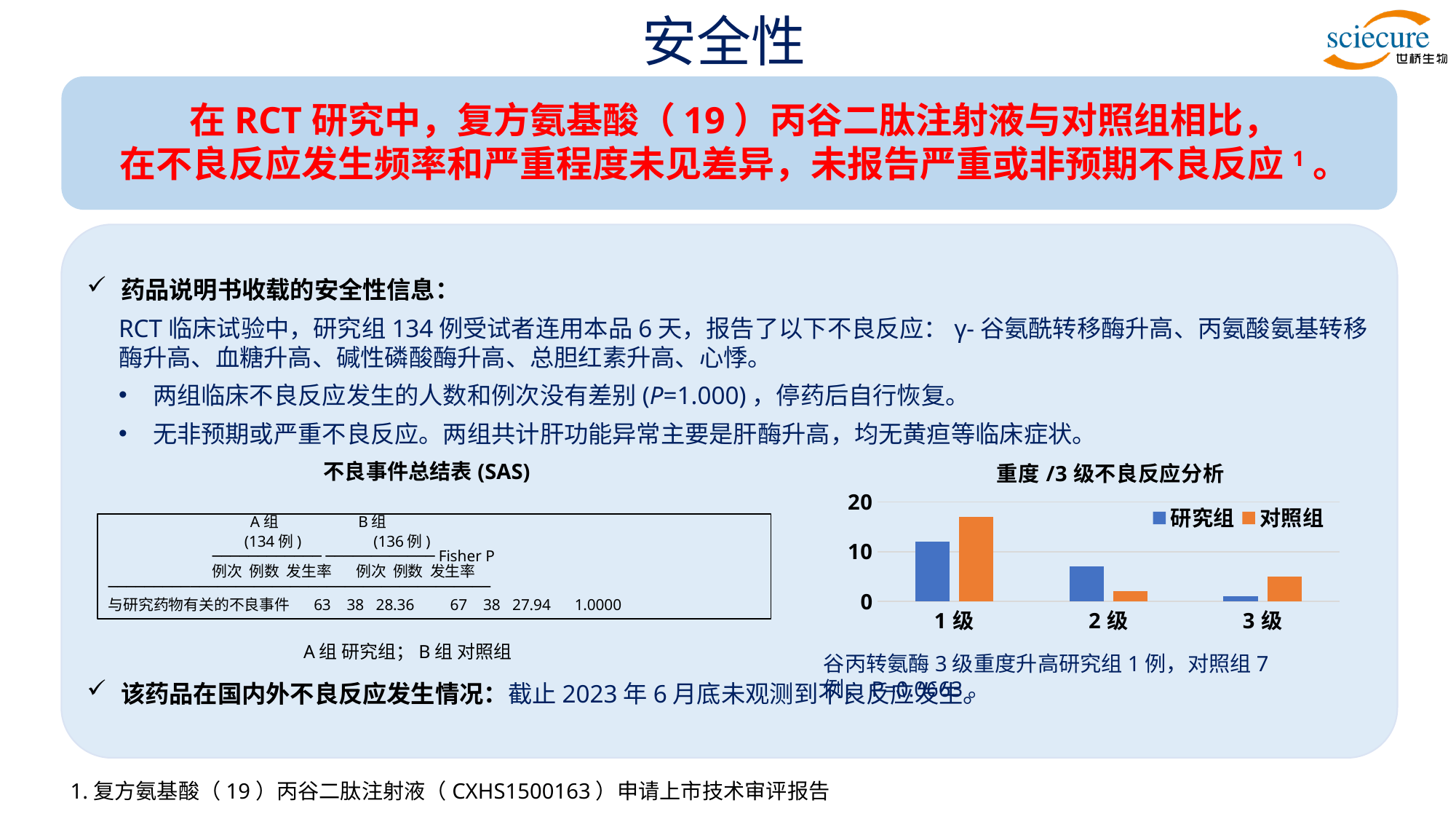
How many series does the legend of the 重度/3级不良反应分析 chart list? 2 In the 重度/3级不良反应分析 chart, which series has the larger value at 1级, 研究组 or 对照组? 对照组 How many categories are shown on the x axis of the 重度/3级不良反应分析 chart? 3 In the 重度/3级不良反应分析 chart, is the value for 研究组 at 2级 greater or less than 10? less In the 重度/3级不良反应分析 chart, which series has the larger value at 2级, 研究组 or 对照组? 研究组 What is the title of the bar chart on the right of the slide? 重度/3级不良反应分析 In the 重度/3级不良反应分析 chart, which category has the lowest value for 研究组? 3级 In the 重度/3级不良反应分析 chart, which category has the highest value for 对照组? 1级 In the 重度/3级不良反应分析 chart, do the values for 研究组 rise or fall from 1级 to 3级? fall What kind of chart is the 重度/3级不良反应分析 chart? bar chart In the 重度/3级不良反应分析 chart, is the value for 对照组 at 1级 greater or less than 10? greater In the 重度/3级不良反应分析 chart, which colour represents 对照组? orange